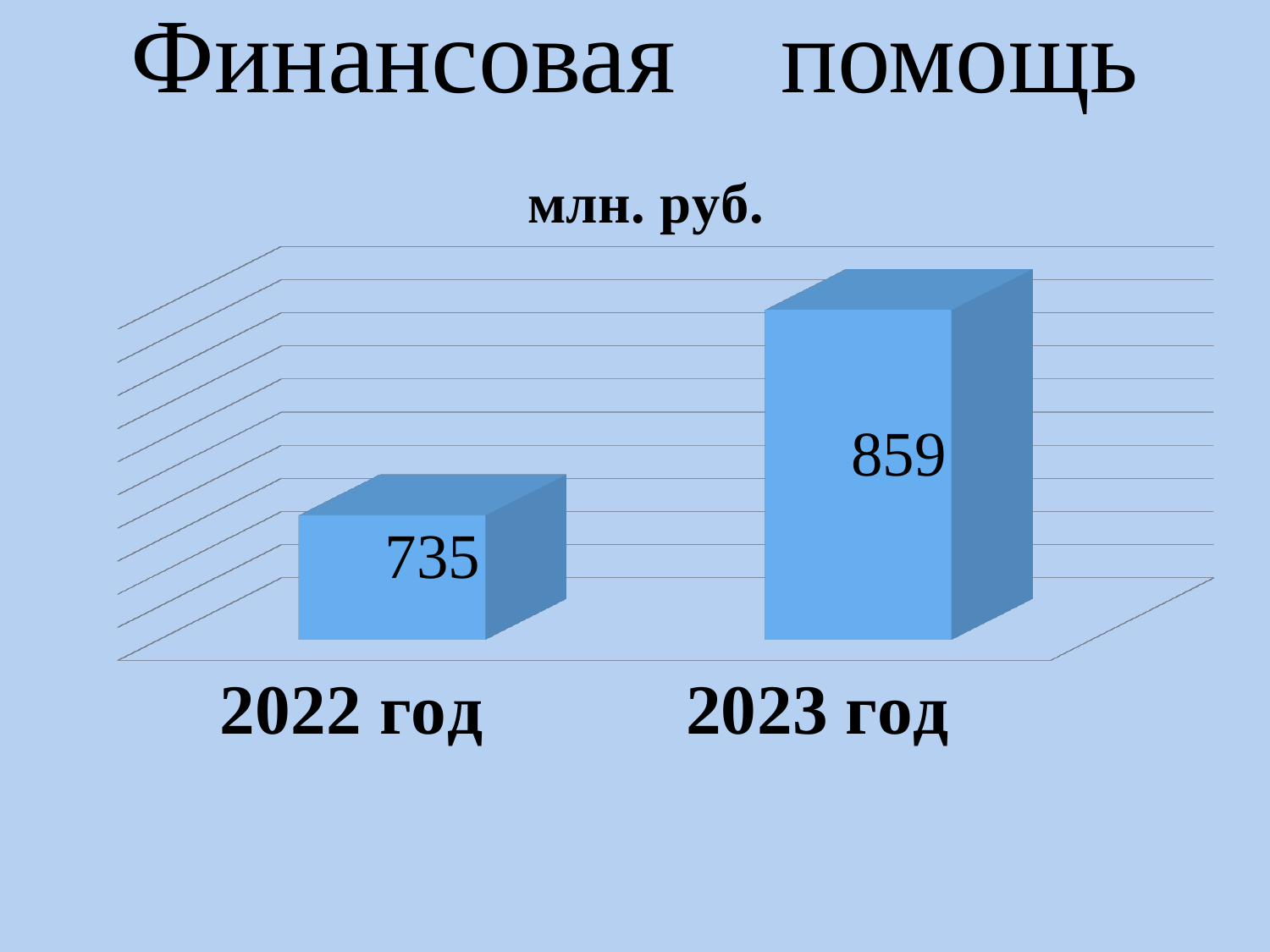
Which year has the lowest value? 2022 год Which year has the highest value? 2023 год Do the values rise or fall from 2022 год to 2023 год? rise How many categories are shown in the chart? 2 What is the title of the slide? Финансовая помощь What is the title of the chart? млн. руб. What kind of chart is shown on the slide? bar chart What is the value for 2023 год? 859 What is the value for 2022 год? 735 Which is larger, the value for 2022 год or the value for 2023 год? 2023 год What is the difference between the values for 2023 год and 2022 год? 124